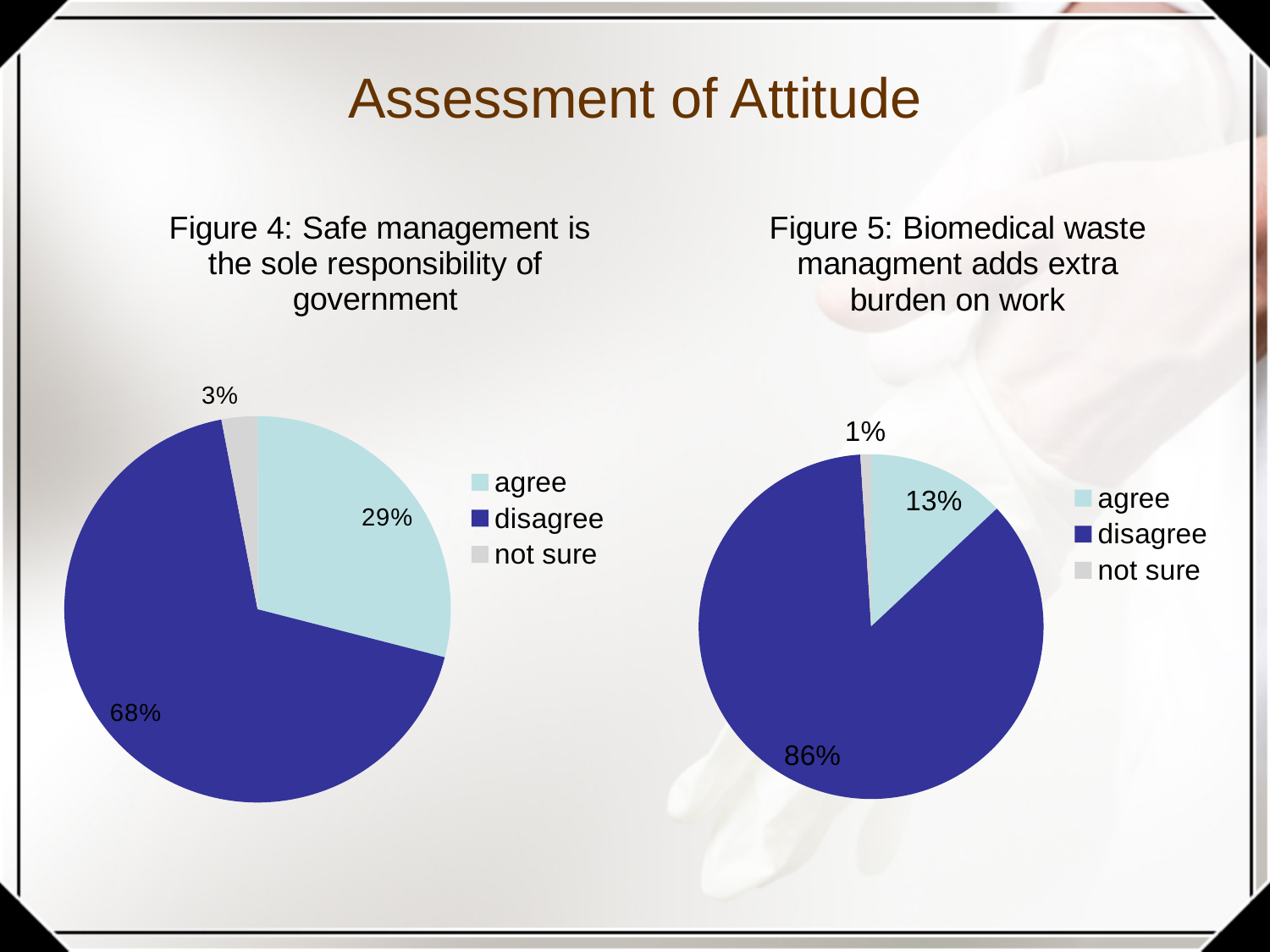
Which chart has a larger agree share, Figure 4 or Figure 5? Figure 4 In the Figure 4 pie chart, which response has the largest slice? disagree What type of chart is used in Figure 5? pie chart In the Figure 5 pie chart, what share of respondents agree? 13% In the Figure 4 pie chart (Safe management is the sole responsibility of government), what percentage of respondents disagree? 68% How many categories does the legend of the Figure 4 chart list? 3 What is the difference between the disagree percentages in Figure 5 and Figure 4? 18% In the Figure 4 pie chart, what percentage of respondents are not sure? 3% In the Figure 5 pie chart (Biomedical waste management adds extra burden on work), what percentage of respondents disagree? 86% In the Figure 4 pie chart, what share of respondents agree? 29% In the Figure 5 pie chart, what percentage of respondents are not sure? 1% In the Figure 5 pie chart, which response has the smallest slice? not sure